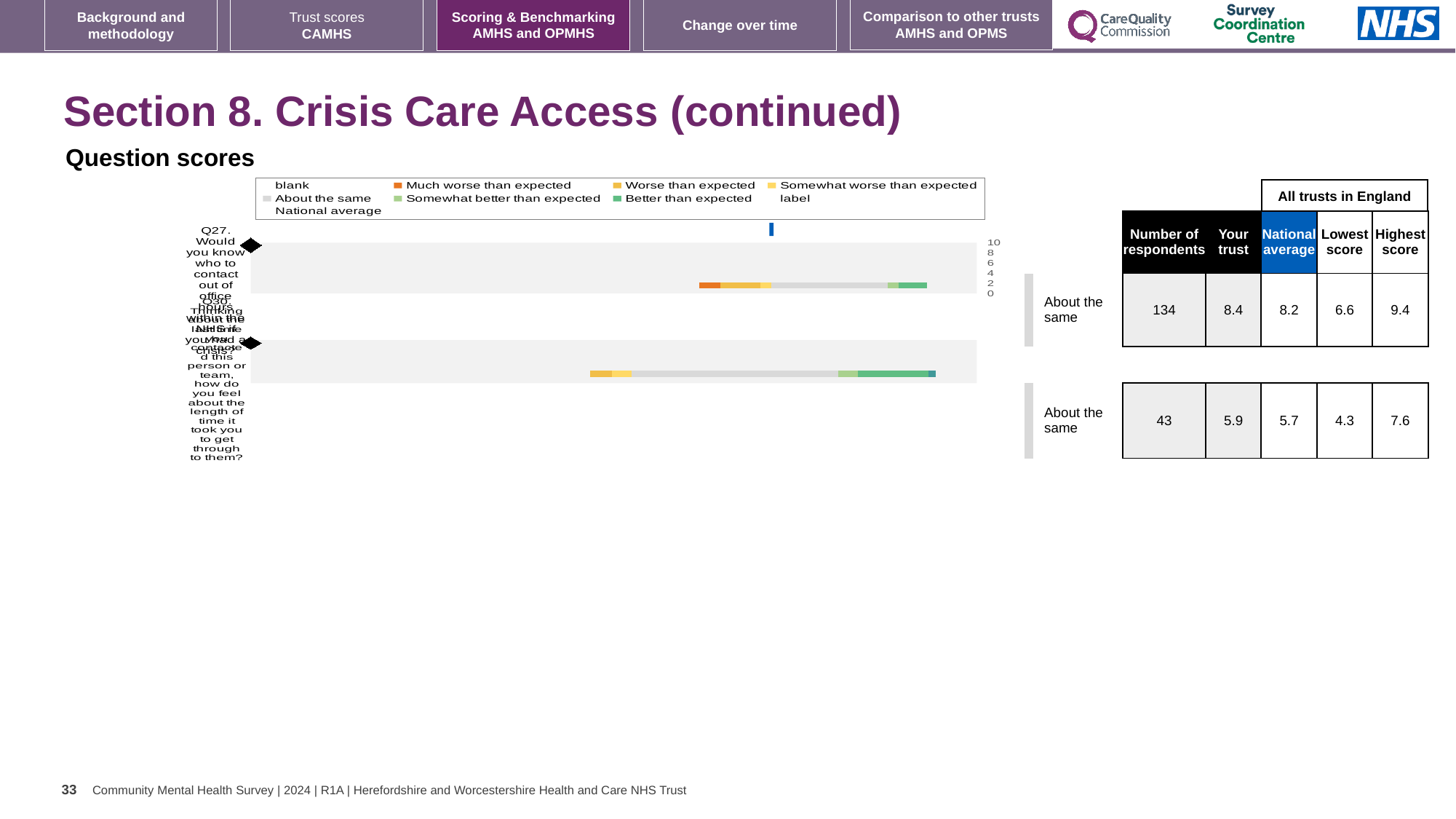
In the table beside the chart, what is the lowest score for the second row (Q30)? 4.3 How many entries does the legend of the question scores chart list? 9 In the legend of the question scores chart, what colour represents 'Much worse than expected'? orange For the second row (Q30), which is larger: the 'Your trust' score or the national average? Your trust (5.9) What benchmark label is shown next to both rows of the question scores chart? About the same How many questions (rows) are plotted in the question scores chart? 2 In the table beside the chart, what is the 'Your trust' score for the first row (Q27)? 8.4 In the table beside the chart, what is the national average for the first row (Q27)? 8.2 In the table beside the chart, what is the number of respondents for the first row (Q27)? 134 For the first row (Q27), how much higher is the 'Your trust' score than the national average? 0.2 In the table beside the chart, what is the highest score for the second row (Q30)? 7.6 What kind of chart is used to show the question scores on this slide? bar chart